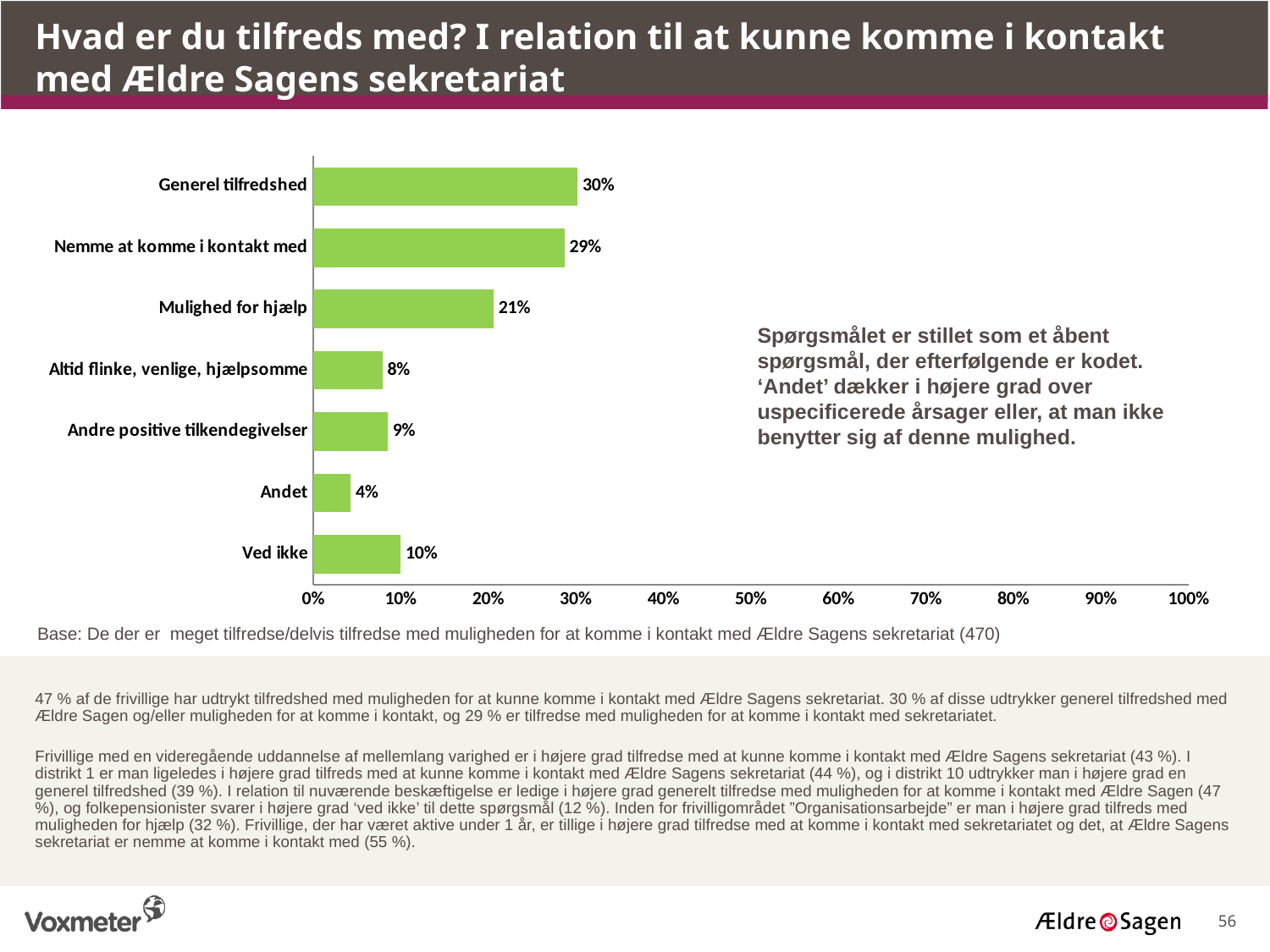
What colour are the bars in the chart? Green Which is larger, 'Altid flinke, venlige, hjælpsomme' or 'Andre positive tilkendegivelser'? Andre positive tilkendegivelser What is the value for 'Generel tilfredshed'? 30% Which category has the lowest value? Andet How many categories are shown in the chart? 7 What is the value for 'Mulighed for hjælp'? 21% What kind of chart is shown on the slide? Bar chart What is the difference between 'Nemme at komme i kontakt med' and 'Mulighed for hjælp'? 8 percentage points What is the maximum value shown on the x axis? 100% What is the value for 'Ved ikke'? 10% Which category has the highest value? Generel tilfredshed Is the value for 'Nemme at komme i kontakt med' greater or less than 20%? greater